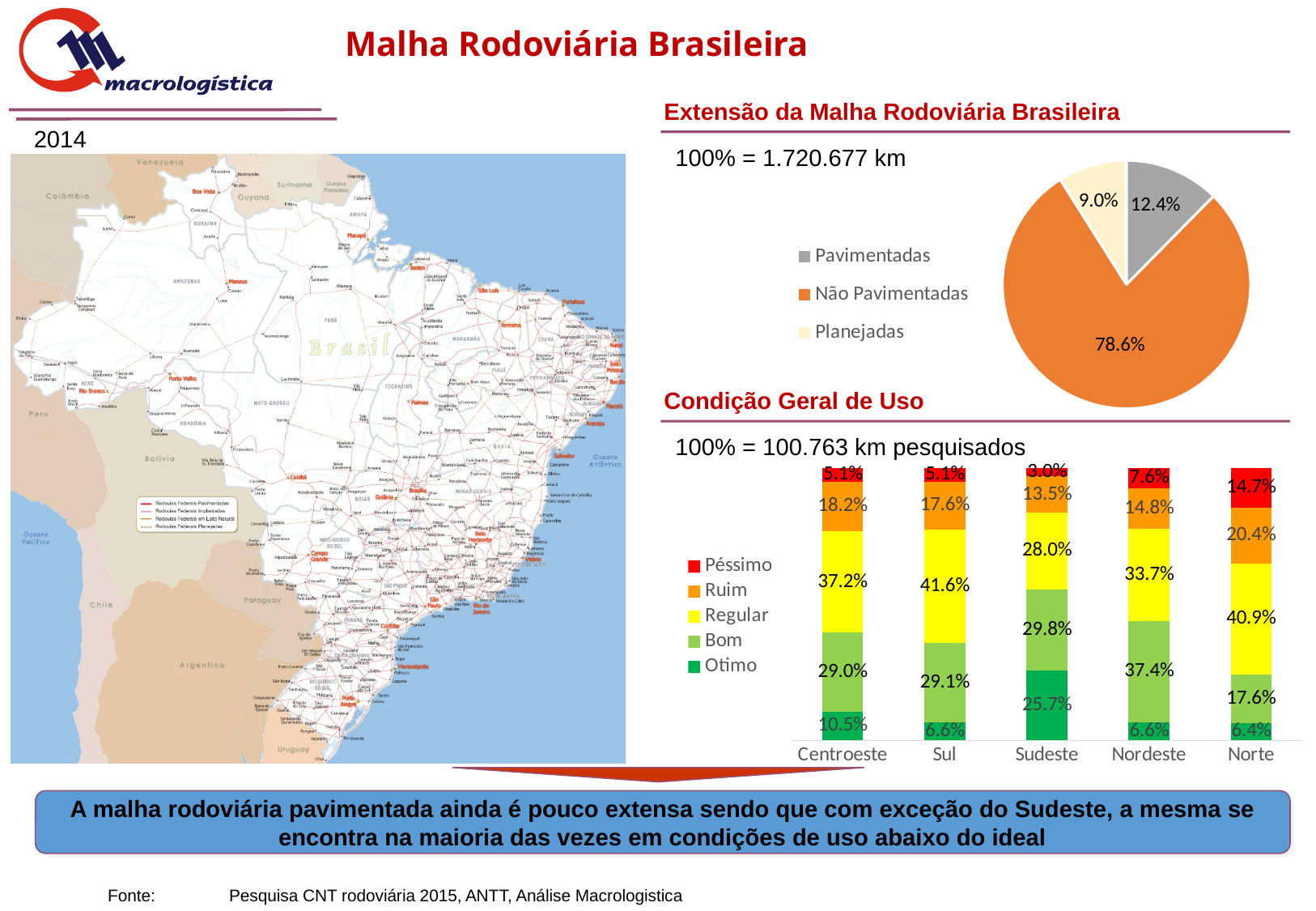
In the 'Extensão da Malha Rodoviária Brasileira' pie chart, what share is Não Pavimentadas? 78.6% In the 'Condição Geral de Uso' chart, which region has the highest Péssimo value? Norte In the 'Condição Geral de Uso' chart, what is the difference between the Bom values for Nordeste and Norte? 19.8% What kind of chart is used for 'Extensão da Malha Rodoviária Brasileira'? Pie chart In the 'Extensão da Malha Rodoviária Brasileira' pie chart, how many categories does the legend list? 3 In the 'Condição Geral de Uso' chart, what is the Ótimo value for Sudeste? 25.7% In the 'Extensão da Malha Rodoviária Brasileira' pie chart, which category has the smallest slice? Planejadas In the 'Condição Geral de Uso' chart, is the Ruim value larger for Centroeste or for Sudeste? Centroeste In the 'Extensão da Malha Rodoviária Brasileira' pie chart, what share is Pavimentadas? 12.4% In the 'Condição Geral de Uso' chart, how many series does the legend list? 5 In the 'Condição Geral de Uso' chart, which region has the lowest Ótimo value? Norte In the 'Condição Geral de Uso' chart, what is the Regular value for Sul? 41.6%